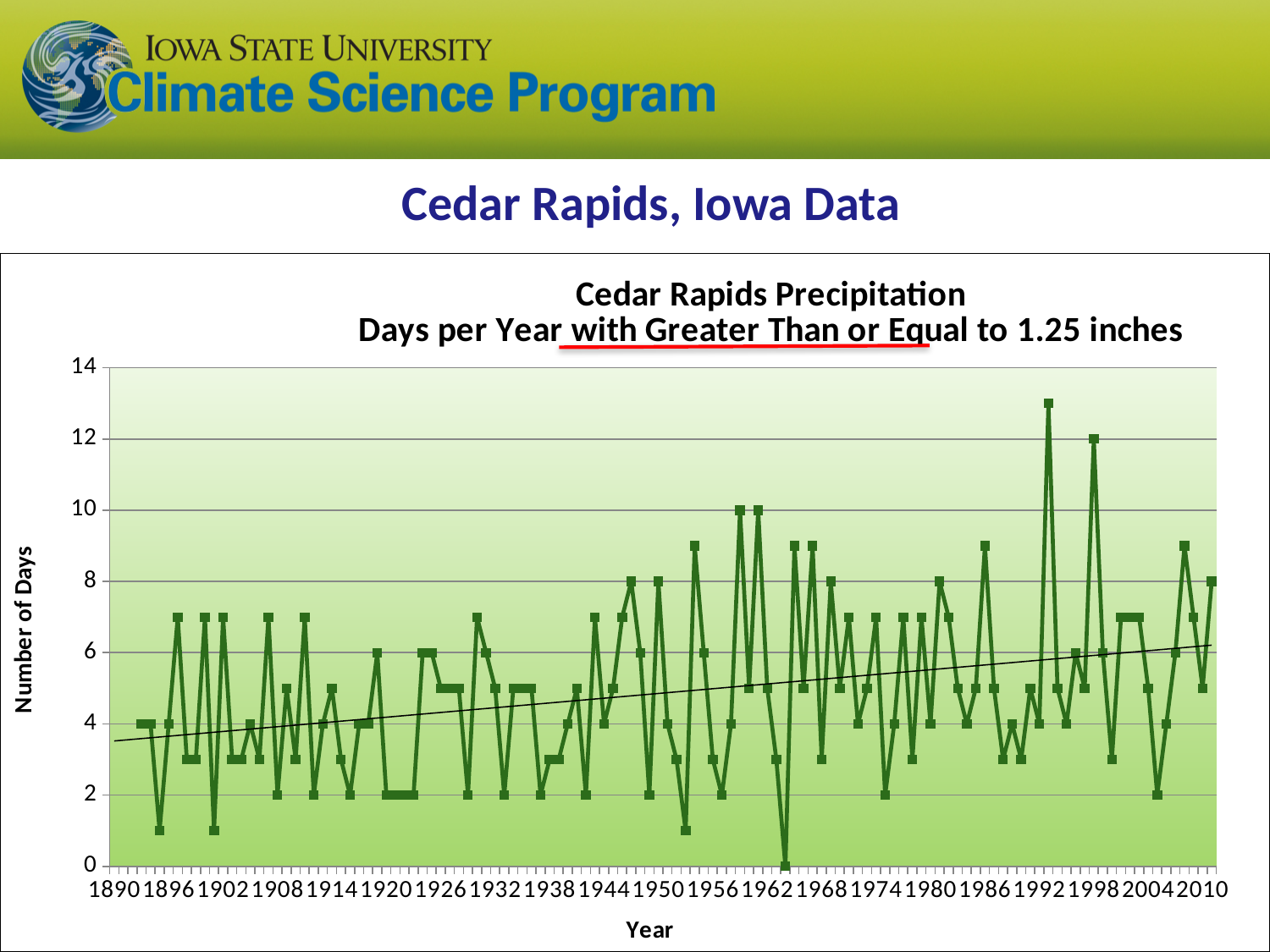
What is the label on the y axis of the chart? Number of Days According to the trend line, do the values rise or fall from 1890 to 2010? rise What is the highest value shown on the y axis? 14 Is the highest value plotted on the chart greater or less than 12? greater What kind of chart is shown on the slide? line chart What is the first year labeled on the x axis? 1890 What is the title of the chart? Cedar Rapids Precipitation Days per Year with Greater Than or Equal to 1.25 inches What is the last year labeled on the x axis? 2010 Is the lowest value plotted on the chart greater or less than 2? less